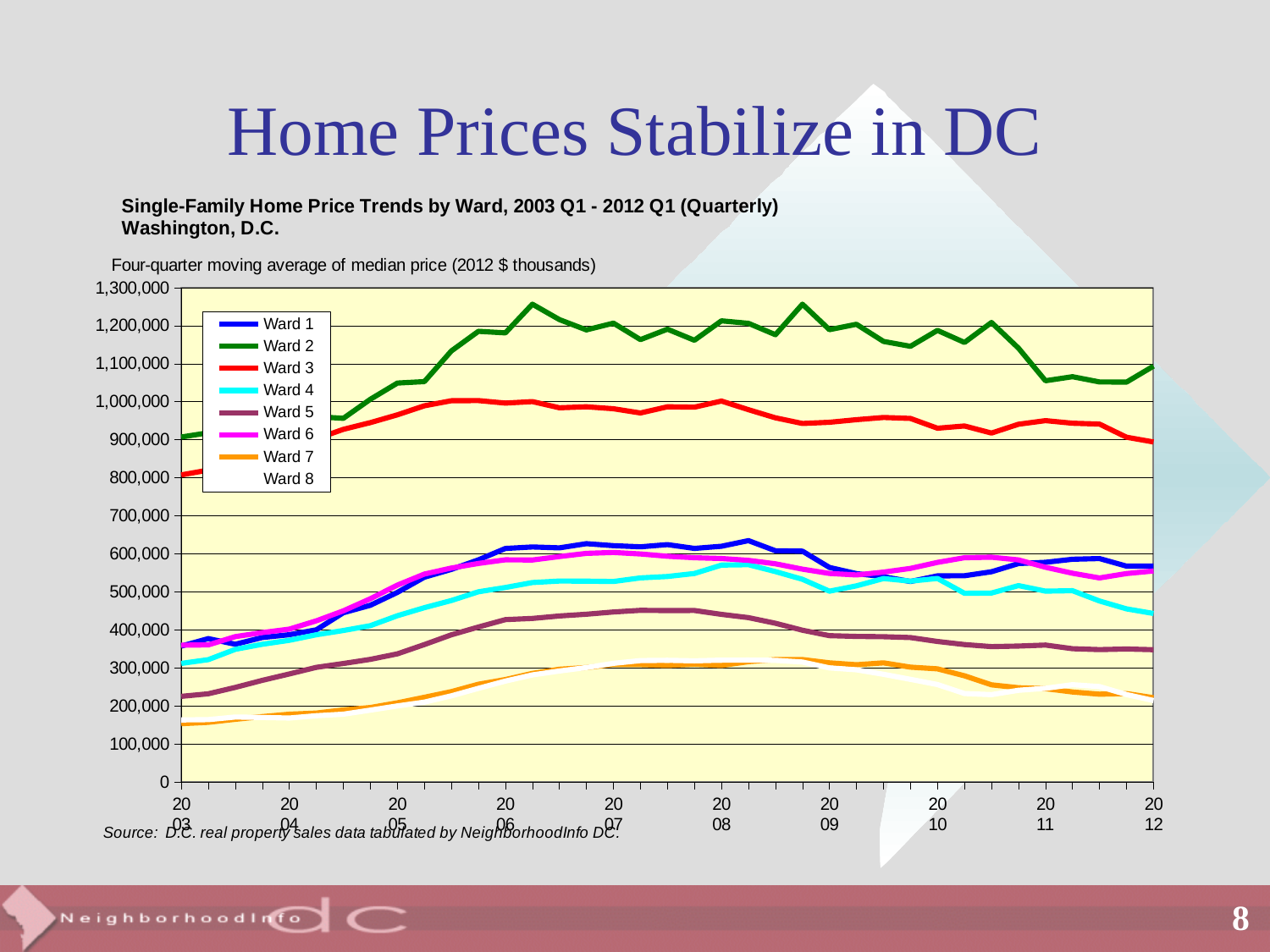
What kind of chart is shown on the slide? line chart How many series does the legend list? 8 Which ward has the highest home prices throughout the period shown? Ward 2 What is the title of the chart? Single-Family Home Price Trends by Ward, 2003 Q1 - 2012 Q1 (Quarterly) Washington, D.C. Does the Ward 4 line rise or fall between 2010 and 2012? fall Is the value for Ward 3 at 2012 greater or less than 800,000? greater Is the value for Ward 4 at 2012 greater or less than 500,000? less Which is larger, the price line for Ward 5 or the price line for Ward 7? Ward 5 Which is larger, the price line for Ward 2 or the price line for Ward 3? Ward 2 Is the peak value for Ward 2 greater or less than 1,200,000? greater Does the Ward 2 line rise or fall between 2003 and 2006? rise